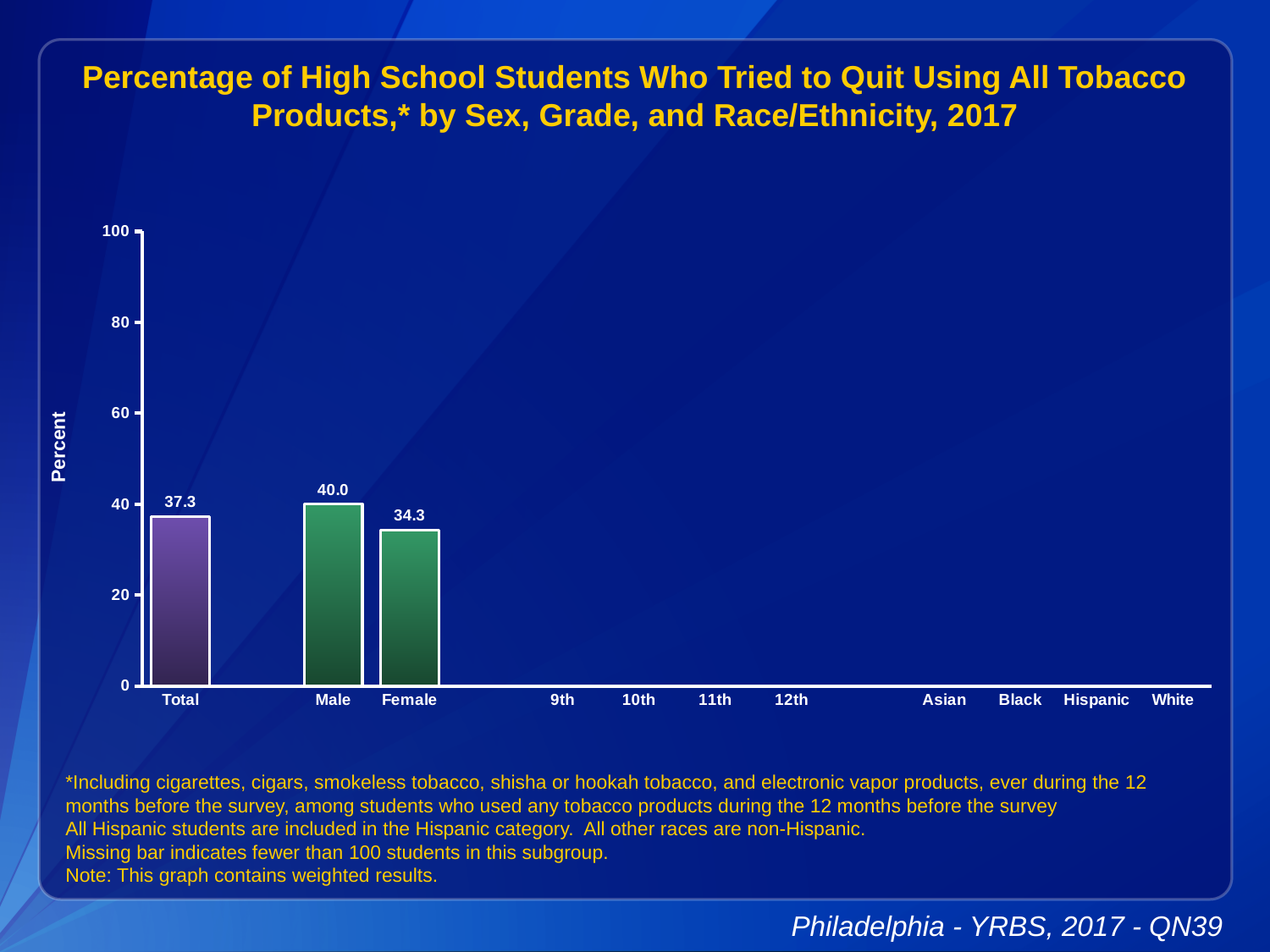
What does a missing bar indicate, according to the note on the slide? Fewer than 100 students in this subgroup How many bars are plotted on the chart? 3 Which plotted category has the highest value? Male What is the value for Male? 40.0 What is the value for Female? 34.3 What is the label of the y axis? Percent What is the value for Total? 37.3 Is the value for Male greater or less than 20? greater Which is larger, the value for Total or the value for Female? Total What is the difference between the Male and Female values? 5.7 What kind of chart is shown on the slide? bar chart Which plotted category has the lowest value? Female